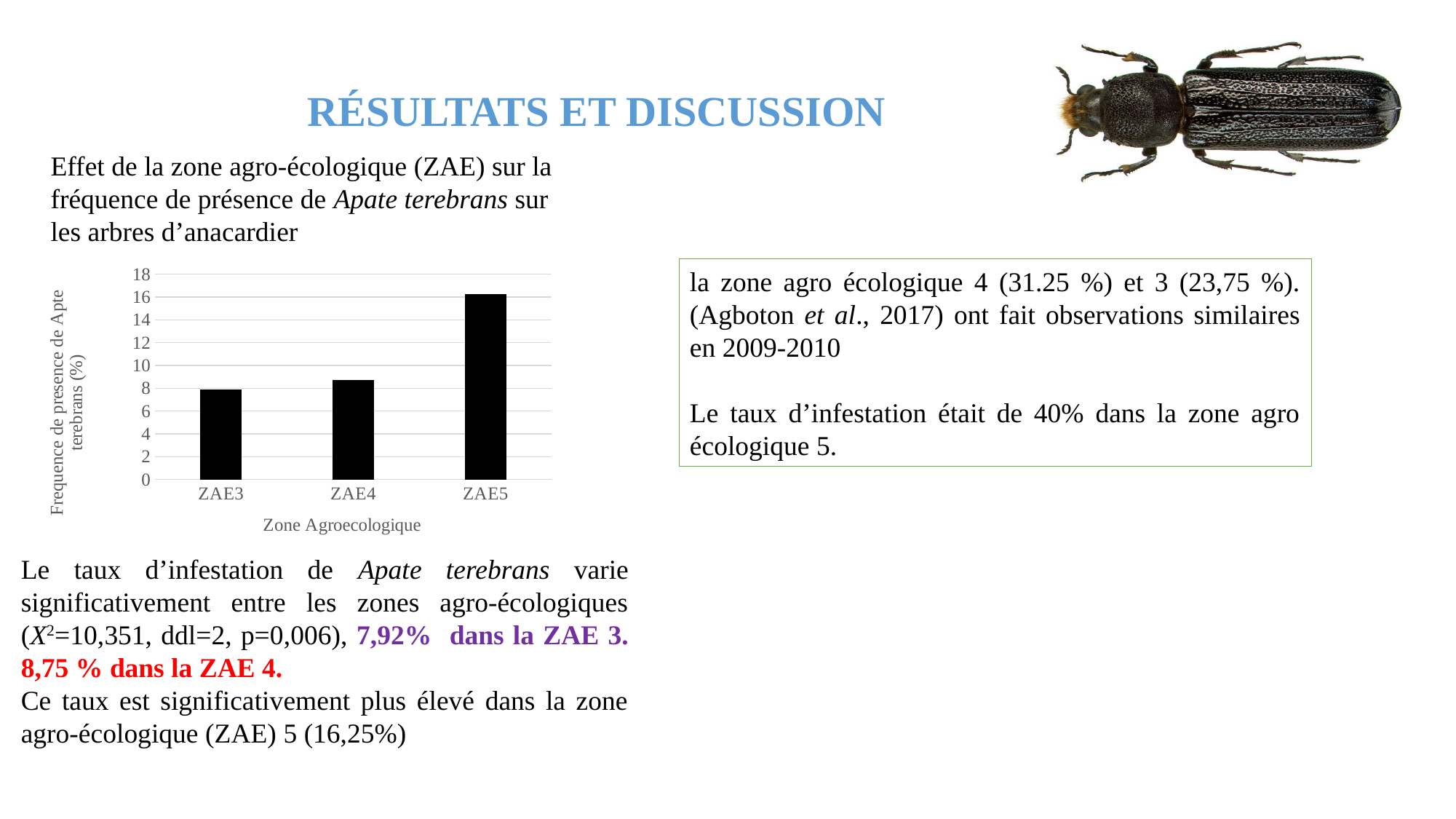
What is the label of the x axis of the chart? Zone Agroecologique Which zone has the lowest frequency of presence of Apate terebrans in the chart? ZAE3 Is the value for ZAE3 greater or less than 6? greater Which has a larger value in the chart, ZAE4 or ZAE5? ZAE5 Which zone has the highest frequency of presence of Apate terebrans in the chart? ZAE5 How many zones (categories) are plotted on the x axis of the chart? 3 Is the value for ZAE5 greater or less than 18? less Is the value for ZAE3 greater or less than 10? less What kind of chart is shown on the slide? bar chart Do the values rise or fall from ZAE3 to ZAE5 along the x axis? rise